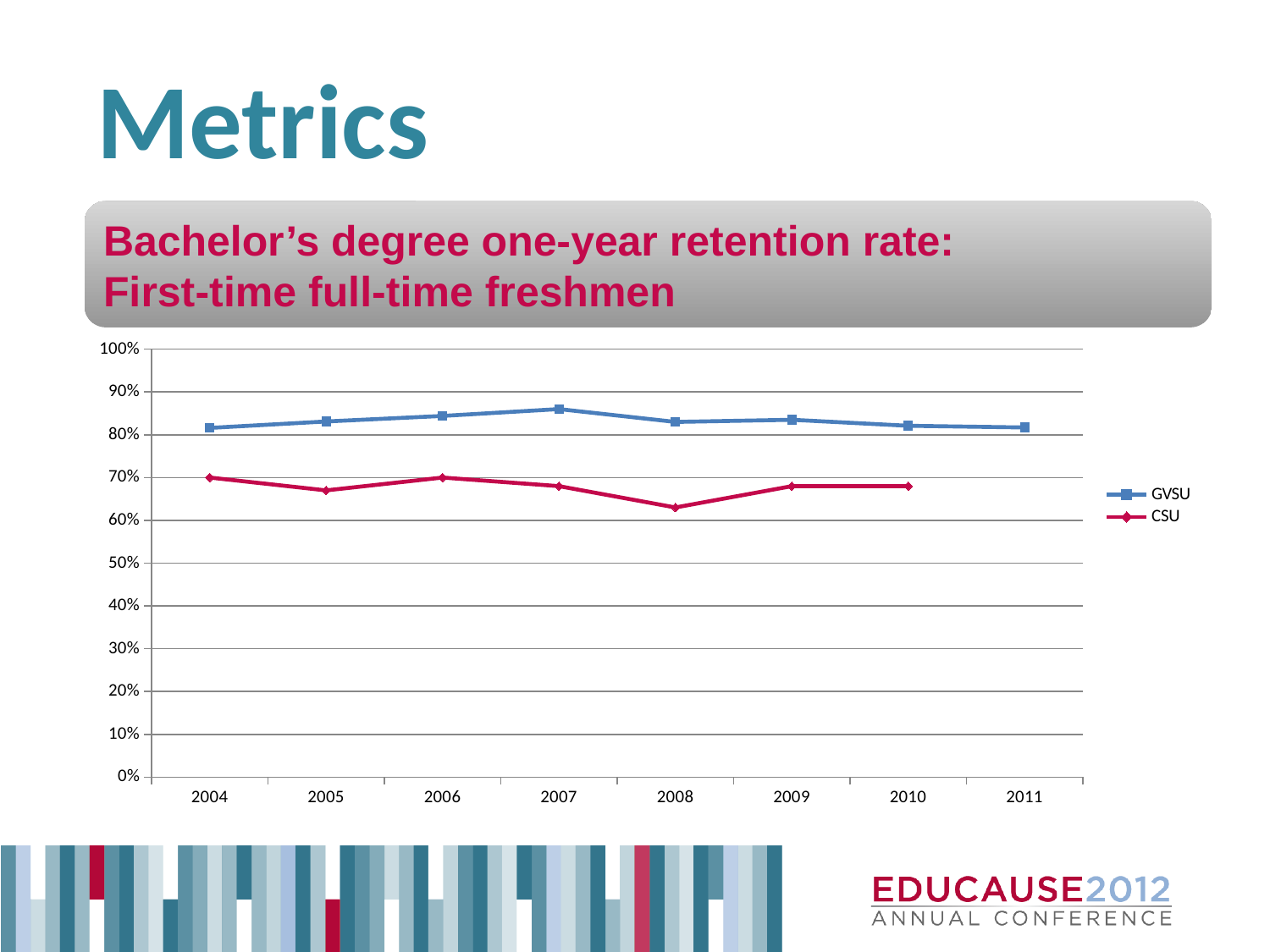
What kind of chart is shown on the slide? line chart What colour is the CSU line? red How many years are shown on the x axis? 8 Is the GVSU value for 2007 greater or less than 80%? greater How many series does the legend list? 2 Which series has the higher retention rate in 2008, GVSU or CSU? GVSU Is the CSU value for 2008 greater or less than 70%? less In which year is the GVSU retention rate highest? 2007 Does the CSU retention rate rise or fall from 2007 to 2008? fall Which two series are listed in the legend? GVSU and CSU Is the GVSU value for 2004 greater or less than 90%? less In which year is the CSU retention rate lowest? 2008